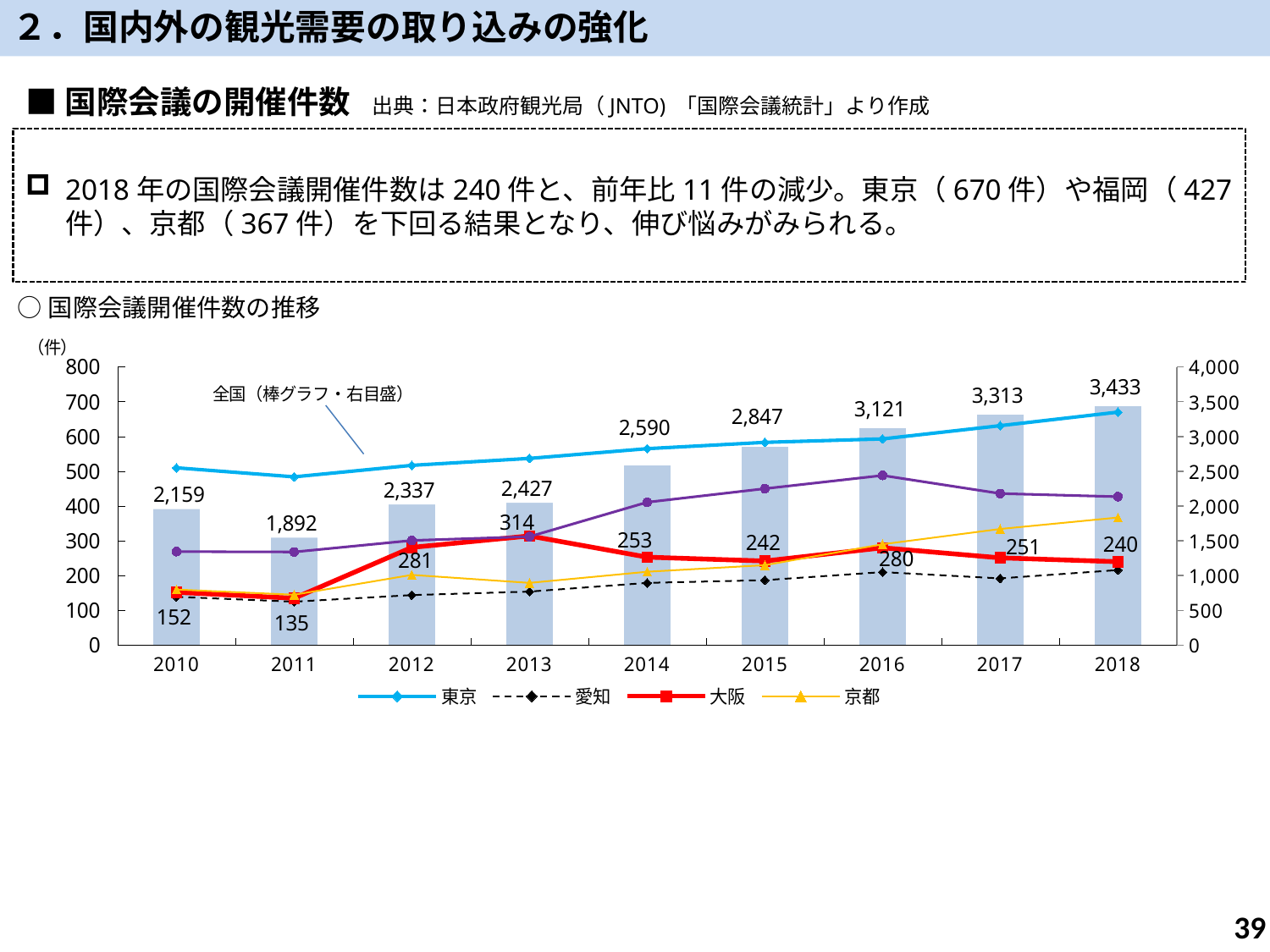
Is the value for 東京 in 2018 greater or less than 600? greater What is the value for 大阪 in 2013? 314 What is the difference between the 全国 bars for 2018 and 2017? 120 In which year does 大阪 reach its highest value? 2013 Which year has the larger 全国 bar, 2014 or 2015? 2015 What is the value of the 全国 bar for 2011? 1,892 How many years are shown on the x axis? 9 Do the 全国 bars rise or fall from 2011 to 2018? rise How many series does the legend list? 4 In which year does 大阪 have its lowest value? 2011 By how much did the 大阪 value fall from 2017 to 2018? 11 What is the value of the 全国 bar for 2018? 3,433